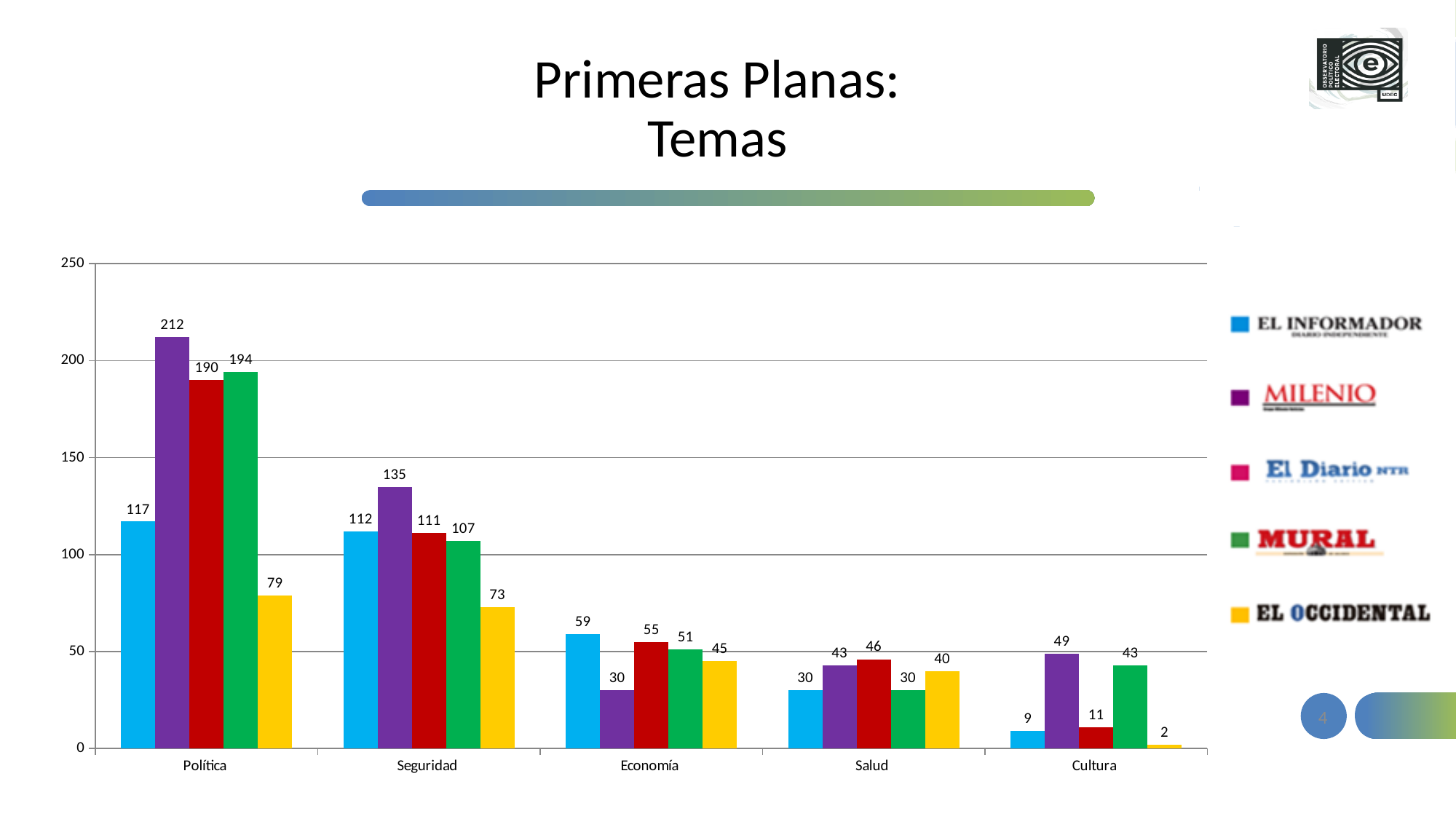
How many topic categories are shown on the x axis? 5 Which newspaper has the lowest value in the Política category? El Occidental What is the difference between Milenio and El Informador in the Política category? 95 Which newspaper has the highest value in the Cultura category? Milenio What is the value for El Occidental in the Seguridad category? 73 What is the value for El Informador in the Economía category? 59 Which is larger in the Salud category, El Diario NTR or El Occidental? El Diario NTR What kind of chart is shown on the slide? bar chart What is the value for Milenio in the Política category? 212 How many newspapers does the legend list? 5 What colour are the bars for El Occidental? yellow